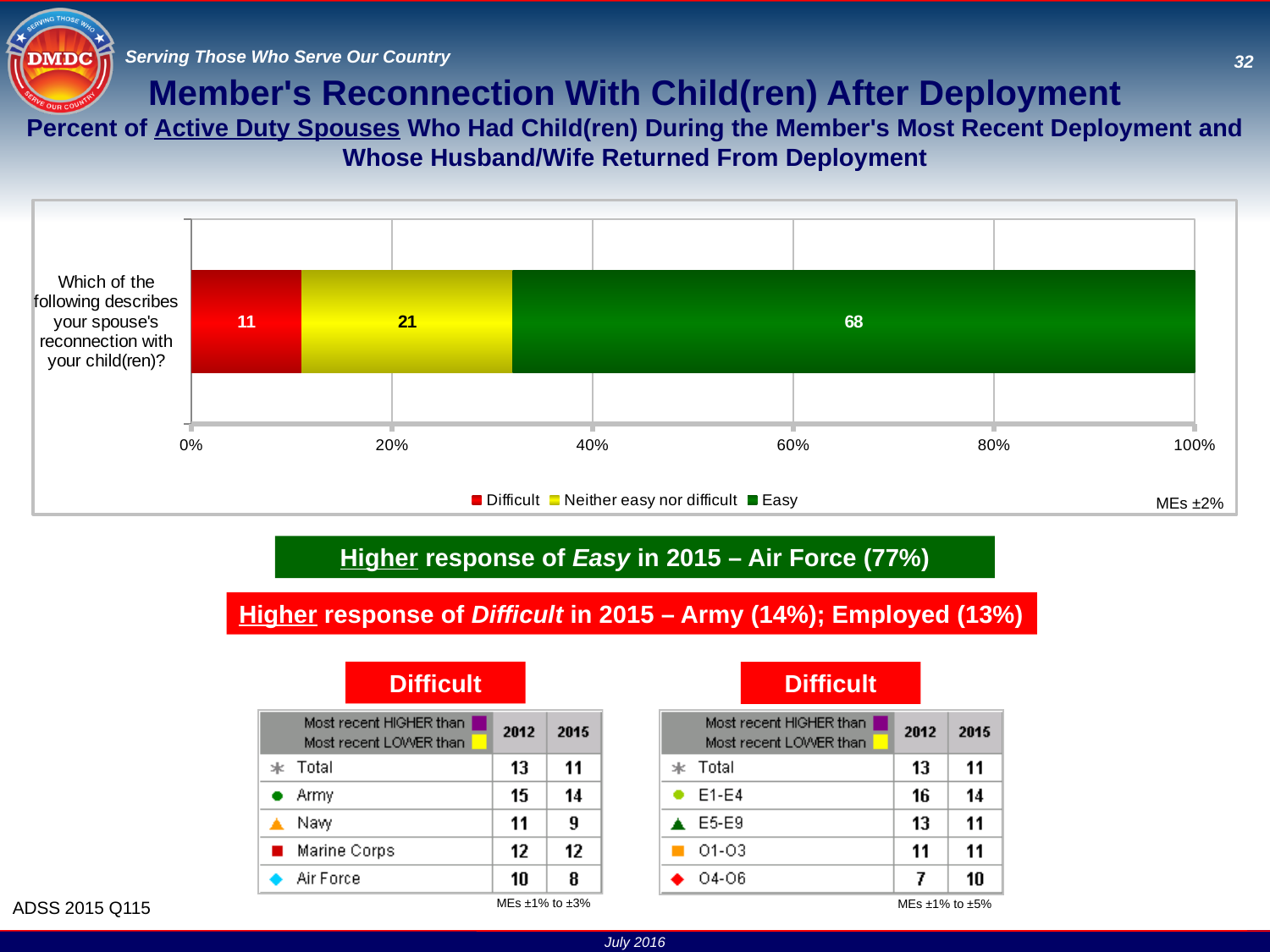
What colour represents the Easy response in the chart? Green How many series does the legend list? 3 What value is shown for the Difficult segment of the bar? 11 What kind of chart is shown on the slide? Stacked bar chart What value is shown for the Easy segment of the bar? 68 Which response category has the smallest segment in the bar? Difficult What is the difference between the Easy value and the Difficult value? 57 What value is shown for the Neither easy nor difficult segment? 21 Which is larger, the Neither easy nor difficult segment or the Difficult segment? Neither easy nor difficult Which response category has the largest segment in the bar? Easy What is the total of the three segments in the stacked bar? 100 Is the Easy segment greater or less than 60%? greater